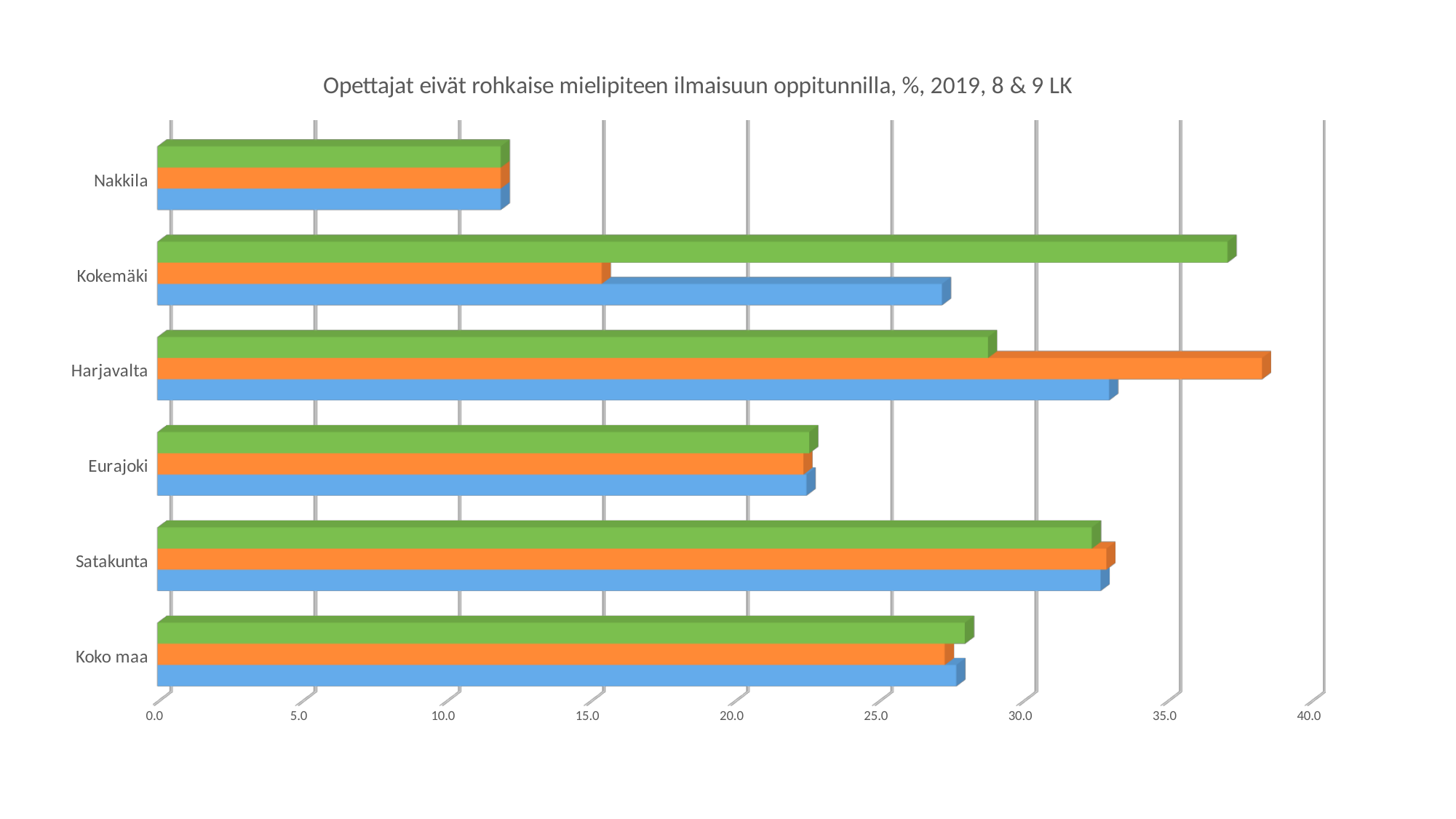
Is the blue bar for Nakkila greater or less than 15.0? less Which category has the longest orange bar? Harjavalta How many bars are shown for each category in the chart? 3 For Kokemäki, which is larger: the green bar or the orange bar? the green bar Is the green bar for Kokemäki greater or less than 35.0? greater Is the orange bar for Satakunta greater or less than 30.0? greater Which category has the longest green bar? Kokemäki What kind of chart is shown on the slide? bar chart Which is larger: the green bar for Eurajoki or the green bar for Nakkila? Eurajoki Which category has the shortest bars overall? Nakkila What is the title of the chart? Opettajat eivät rohkaise mielipiteen ilmaisuun oppitunnilla, %, 2019, 8 & 9 LK How many categories are listed on the vertical axis of the chart? 6